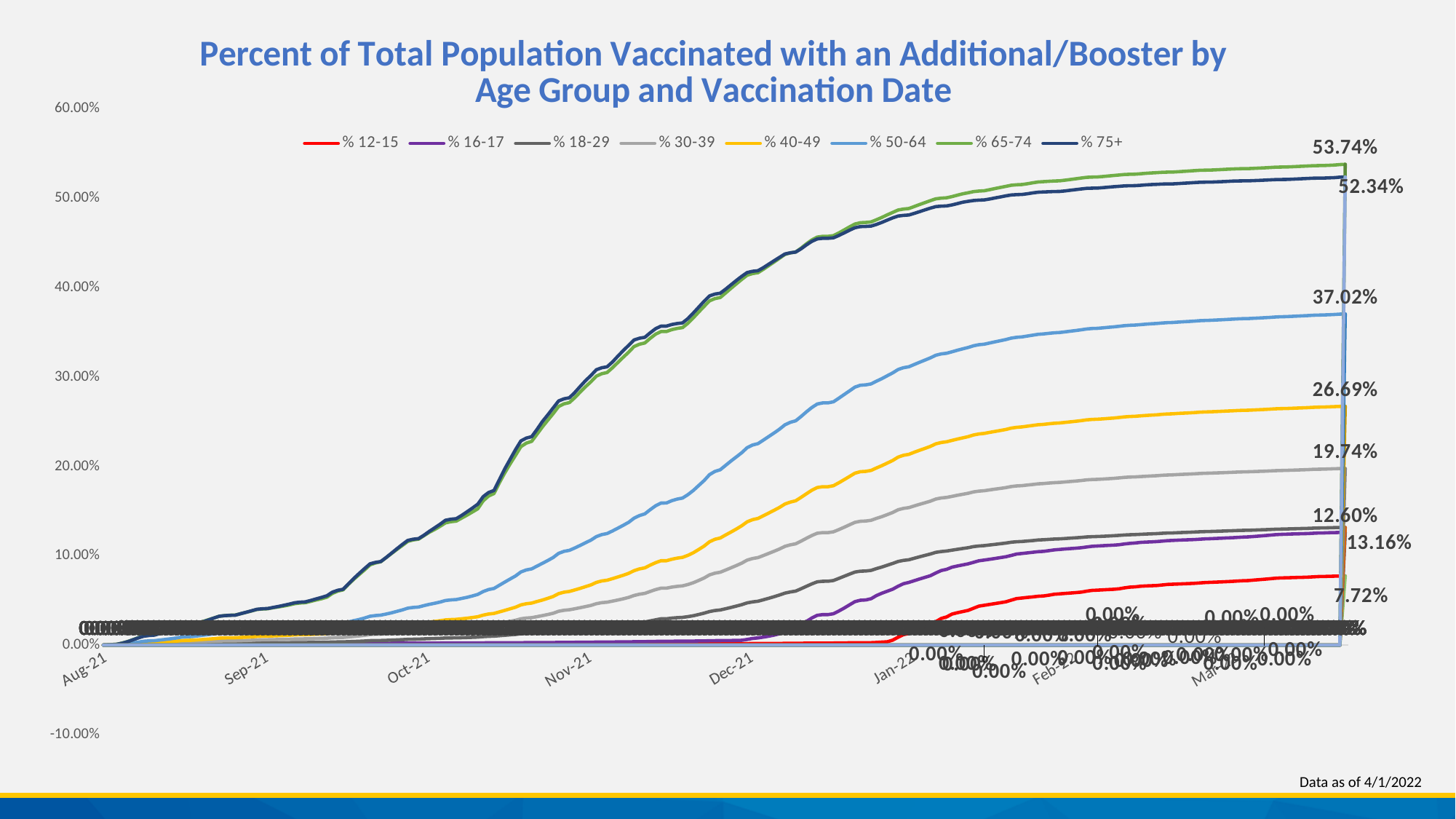
What kind of chart is shown on the slide? line chart Which age group has the lowest percentage at the end of the chart? % 12-15 As of what date is the data in the chart reported? 4/1/2022 How many age-group series does the legend list? 8 What is the final labelled value for the % 65-74 series? 53.74% Do the values for the % 50-64 series rise or fall from Aug-21 to Mar-22? rise What is the difference between the final values of the % 65-74 and % 75+ series? 1.40% What is the final labelled value for the % 12-15 series? 7.72% What is the final labelled value for the % 50-64 series? 37.02% Which age group has the highest percentage at the end of the chart? % 65-74 What is the final labelled value for the % 40-49 series? 26.69% What is the final labelled value for the % 75+ series? 52.34%